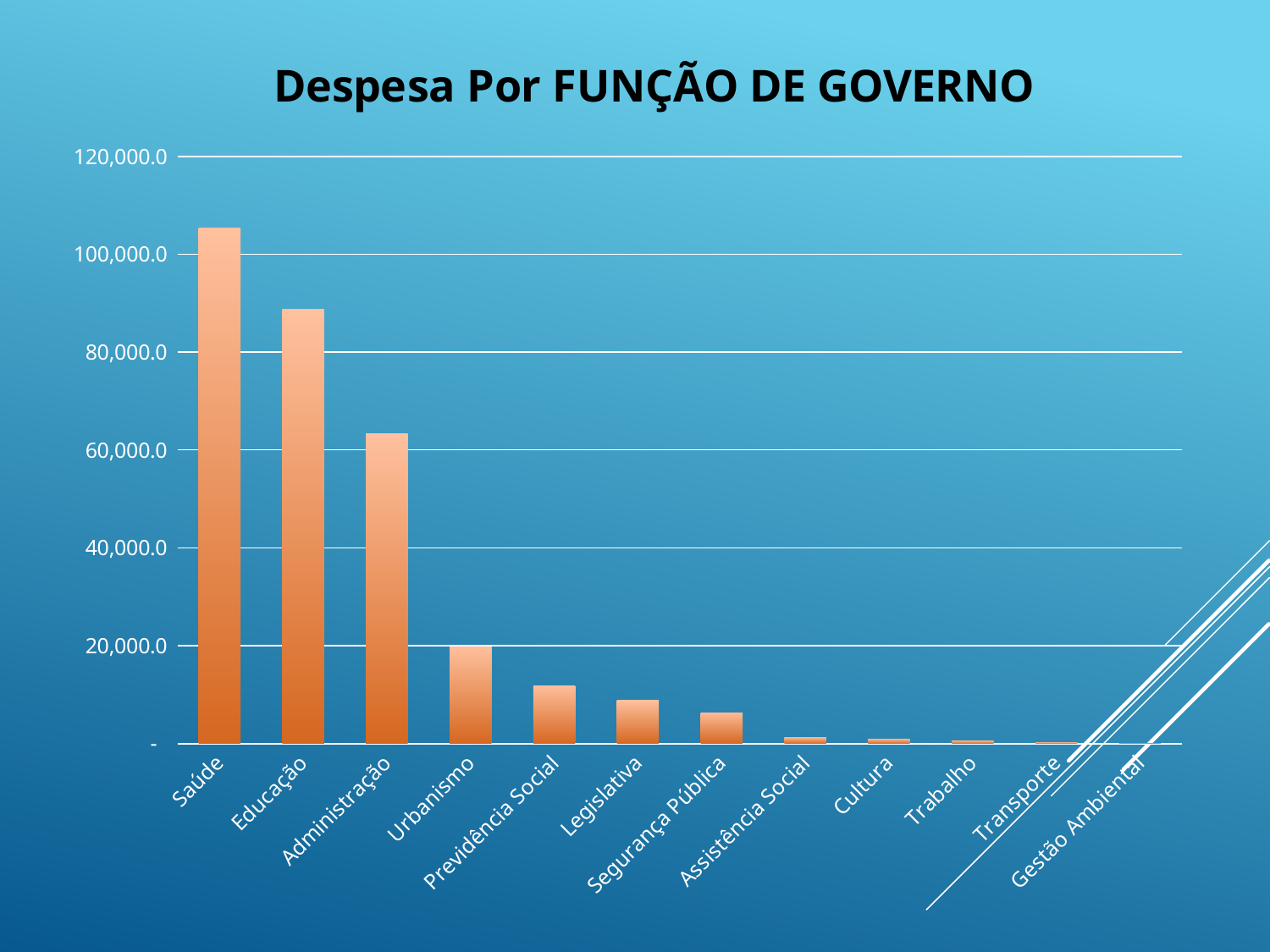
What kind of chart is shown on the slide? bar chart What is the title of the chart? Despesa Por FUNÇÃO DE GOVERNO Which has a larger expense, Legislativa or Segurança Pública? Legislativa Which has a larger expense, Educação or Administração? Educação Which government function has the highest expense? Saúde Is the value for Urbanismo greater or less than 40,000.0? less Is the value for Previdência Social greater or less than 20,000.0? less Is the value for Administração greater or less than 60,000.0? greater How many categories (government functions) are shown on the x axis? 12 Do the values rise or fall moving from left to right along the x axis? fall